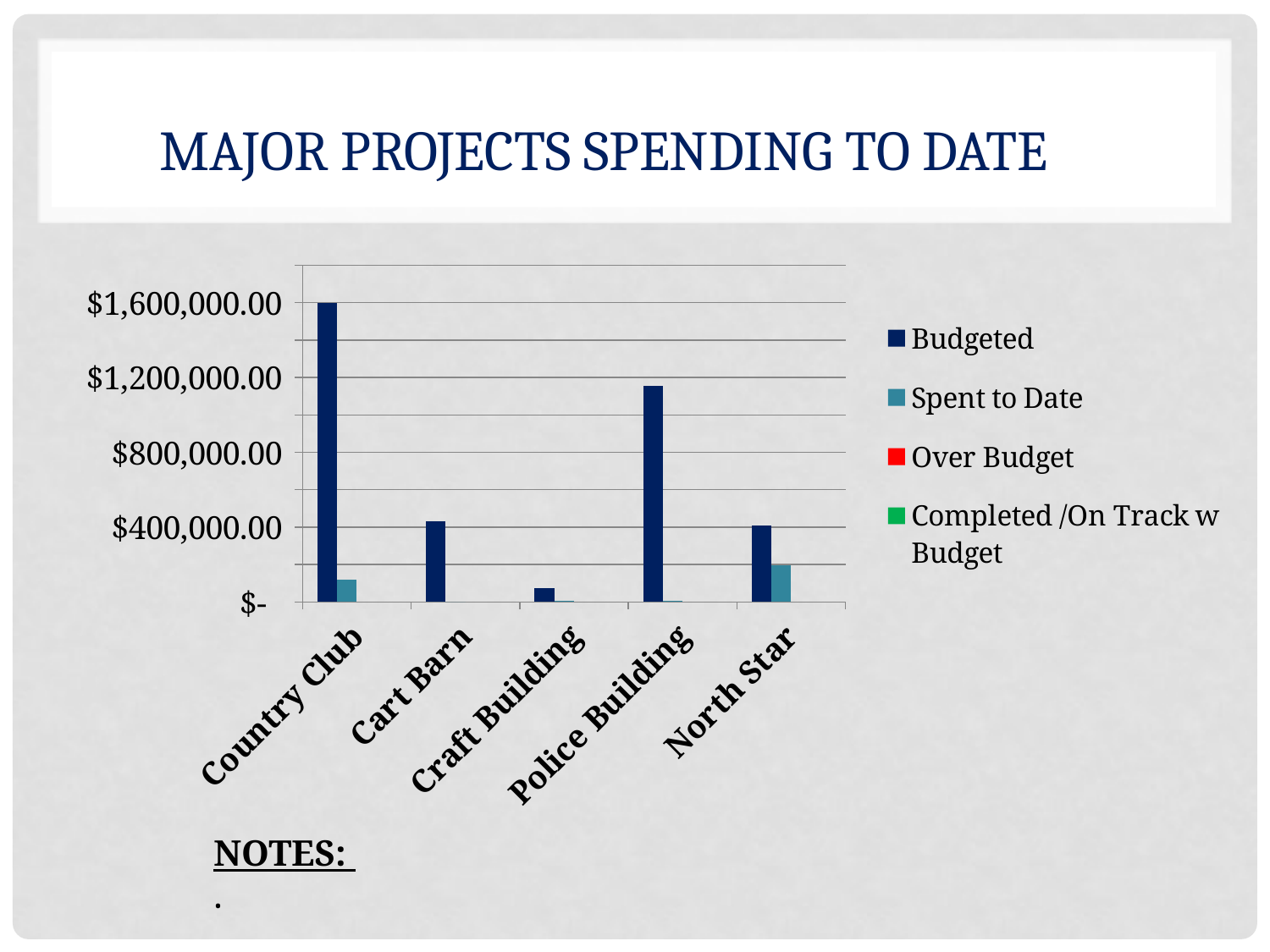
Which project has the highest Spent to Date value? North Star Is the Budgeted value for Police Building greater or less than $1,200,000.00? less Which is larger, the Budgeted value for Country Club or for Police Building? Country Club What is the title of the slide containing the chart? MAJOR PROJECTS SPENDING TO DATE How many series does the chart's legend list? 4 How many projects are shown on the x axis of the chart? 5 Which project has the highest Budgeted value? Country Club Which is larger, the Spent to Date value for North Star or for Country Club? North Star What type of chart is shown on the slide? bar chart Which project has the lowest Budgeted value? Craft Building Is the Budgeted value for Craft Building greater or less than $400,000.00? less Is the Spent to Date value for North Star greater or less than $400,000.00? less